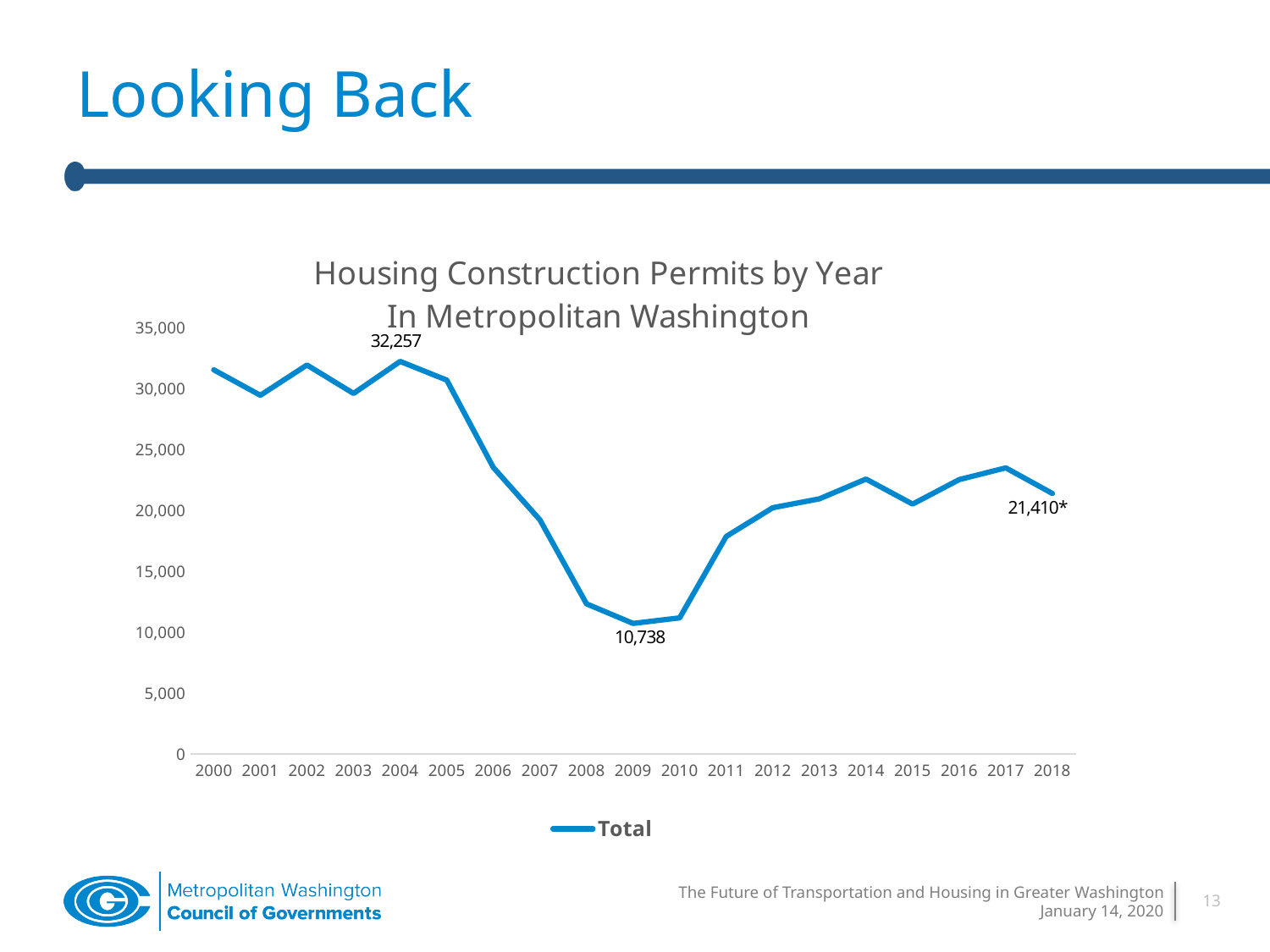
What is the value labeled for 2004? 32,257 Is the value for 2011 greater or less than 20,000? less What type of chart is shown on the slide? Line chart Is the value for 2000 greater or less than 30,000? greater How many years are plotted on the x axis? 19 Do the values rise or fall from 2004 to 2009? fall Which year has the lowest number of housing construction permits? 2009 What is the difference between the 2004 value and the 2009 value? 21,519 What is the title of the chart? Housing Construction Permits by Year In Metropolitan Washington How many series does the legend list? 1 What is the value labeled for 2018? 21,410* What is the value labeled for 2009? 10,738